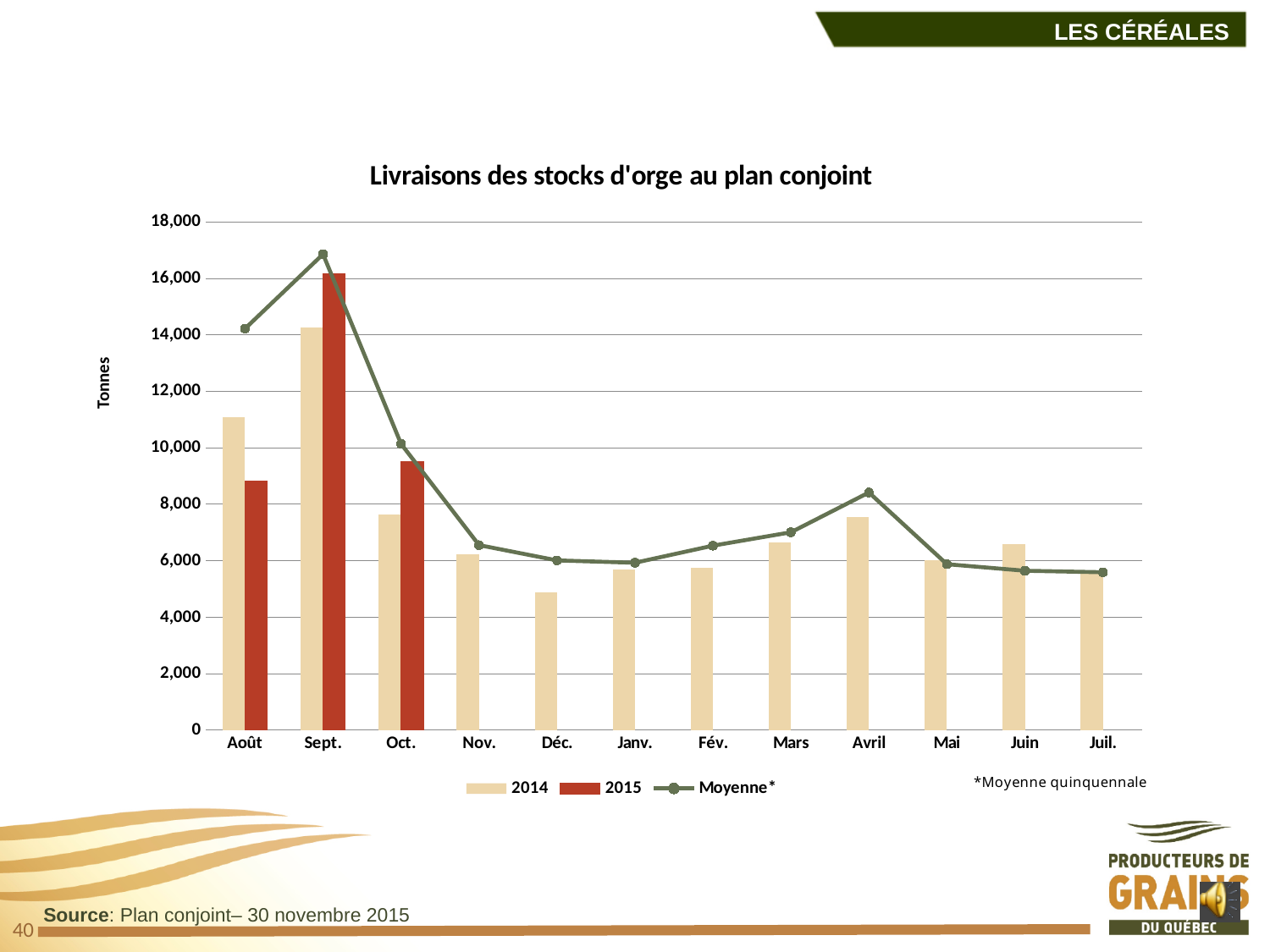
For Août, which is larger: the 2014 bar or the 2015 bar? 2014 Is the 2014 value for Déc. greater or less than 6,000? less How many series does the legend list? 3 Is the Moyenne* value for Avril greater or less than 8,000? greater What is the title of the chart? Livraisons des stocks d'orge au plan conjoint Does the Moyenne* line rise or fall from Sept. to Nov.? fall In which month is the 2014 bar the lowest? Déc. How many months are shown along the x axis? 12 In which month is the 2015 bar the highest? Sept. In which month is the 2014 bar the highest? Sept. Is the 2015 value for Sept. greater or less than 14,000? greater What kind of chart is shown on the slide? A bar chart combined with a line